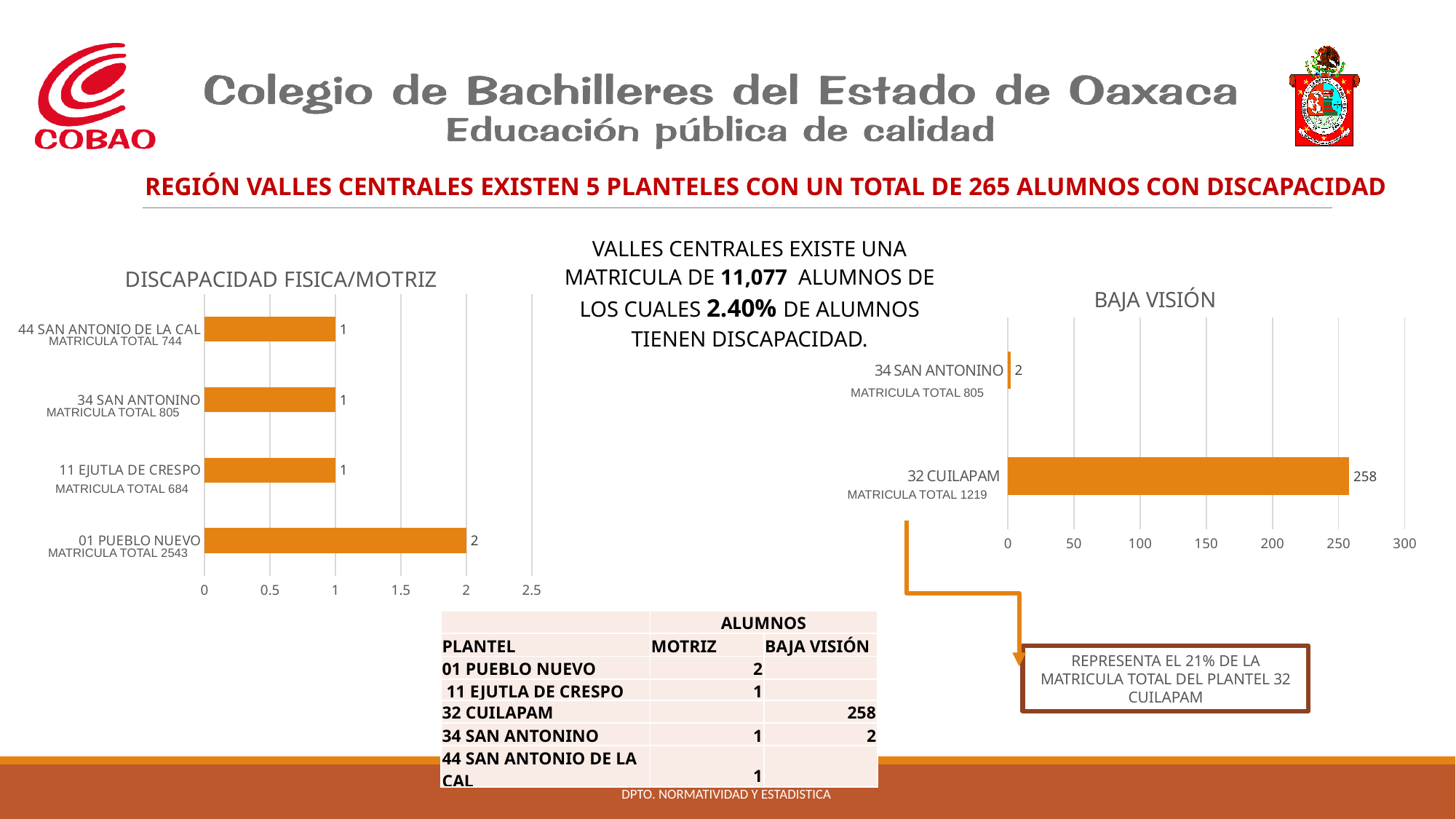
In the BAJA VISIÓN chart, what is the value for 34 SAN ANTONINO? 2 In the BAJA VISIÓN chart, what is the value for 32 CUILAPAM? 258 What kind of chart is the DISCAPACIDAD FISICA/MOTRIZ chart? Bar chart In the DISCAPACIDAD FISICA/MOTRIZ chart, how many planteles are plotted? 4 In the DISCAPACIDAD FISICA/MOTRIZ chart, what is the value for 01 PUEBLO NUEVO? 2 In the DISCAPACIDAD FISICA/MOTRIZ chart, which plantel has the highest value? 01 PUEBLO NUEVO In the DISCAPACIDAD FISICA/MOTRIZ chart, what is the value for 11 EJUTLA DE CRESPO? 1 In the DISCAPACIDAD FISICA/MOTRIZ chart, what is the difference between the values for 01 PUEBLO NUEVO and 34 SAN ANTONINO? 1 In the BAJA VISIÓN chart, how many planteles are plotted? 2 In the BAJA VISIÓN chart, what is the difference between the values for 32 CUILAPAM and 34 SAN ANTONINO? 256 In the BAJA VISIÓN chart, which plantel has the lowest value? 34 SAN ANTONINO In the BAJA VISIÓN chart, is the value for 32 CUILAPAM greater or less than 250? greater